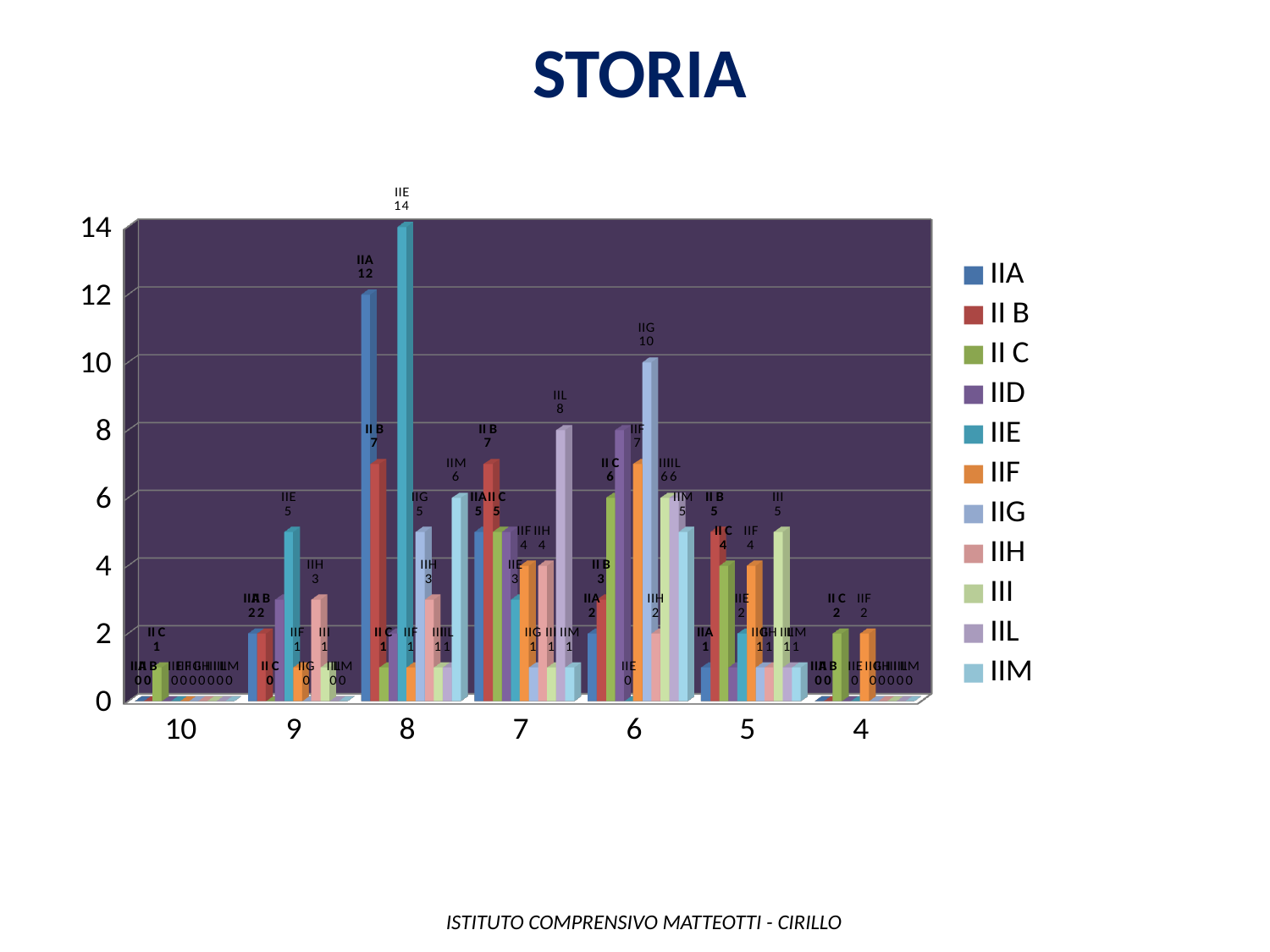
What is the difference between the values for IIE and IIA in category 8? 2 What is the value for IIA in category 8? 12 What is the value for IIE in category 8? 14 What is the title of the chart? STORIA Which series has the highest value in category 8? IIE What is the value for IIL in category 7? 8 How many series does the legend list? 11 What is the value for IIG in category 6? 10 What kind of chart is shown on the slide? bar chart How many categories are shown along the x axis? 7 In category 6, which is larger: the value for IIG or the value for IIF? IIG What is the value for II C in category 10? 1